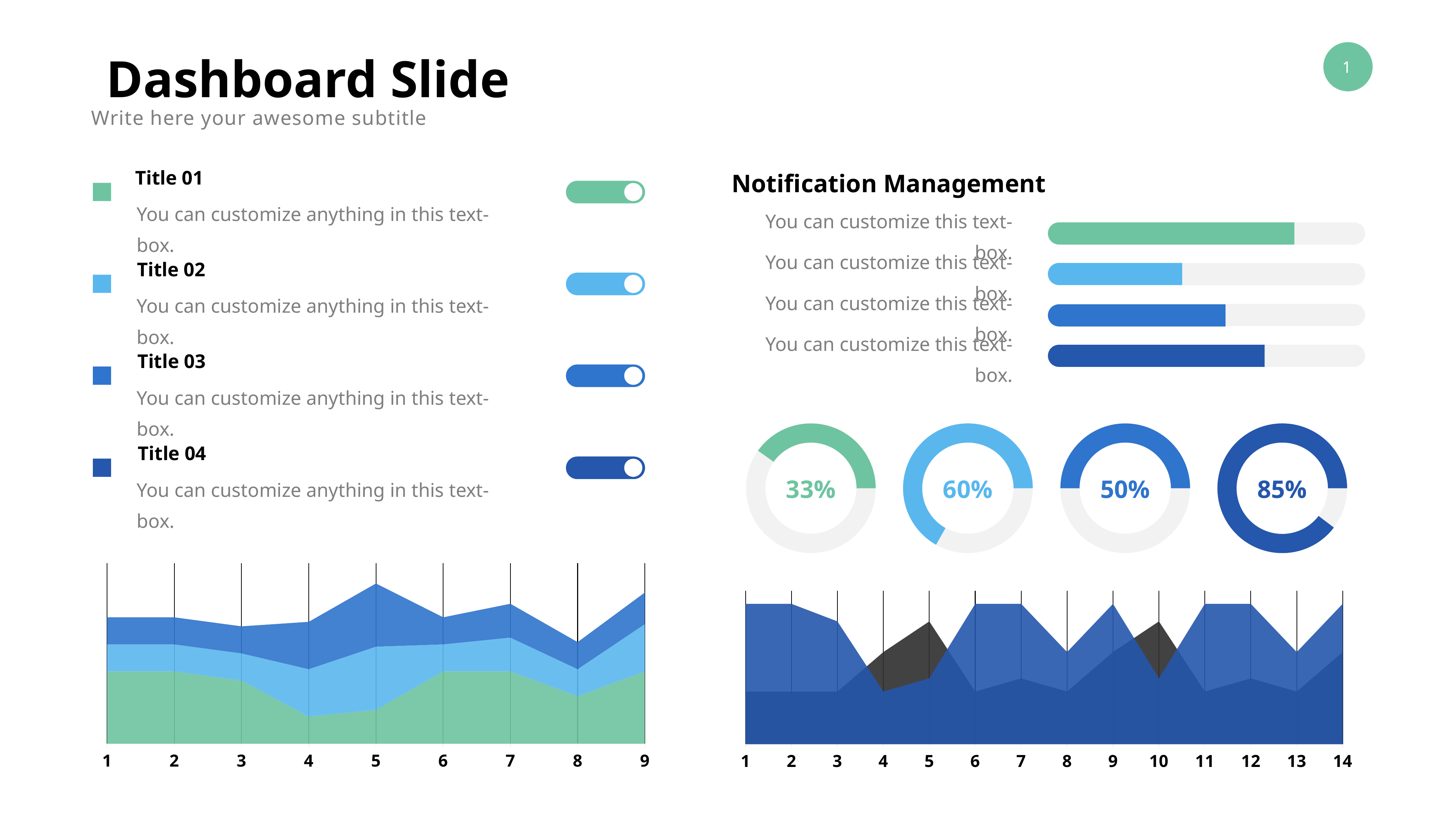
How many points are on the x axis of the area chart at the bottom left of the slide? 9 How many donut charts are shown under Notification Management? 4 What value is shown in the light blue donut chart under Notification Management? 60% What value is shown in the dark blue donut chart, the rightmost one under Notification Management? 85% What kind of chart is shown at the bottom right of the slide? Area chart What is the difference between the values of the rightmost donut chart (85%) and the leftmost donut chart (33%)? 52% What value is shown in the green donut chart under Notification Management? 33% Which of the four donut charts under Notification Management shows the highest value? 85% How many points are on the x axis of the area chart at the bottom right of the slide? 14 Which of the four donut charts under Notification Management shows the lowest value? 33% Which is larger, the value in the light blue donut chart or the value in the medium blue donut chart? The light blue donut chart (60%) What kind of chart is shown at the bottom left of the slide? Area chart